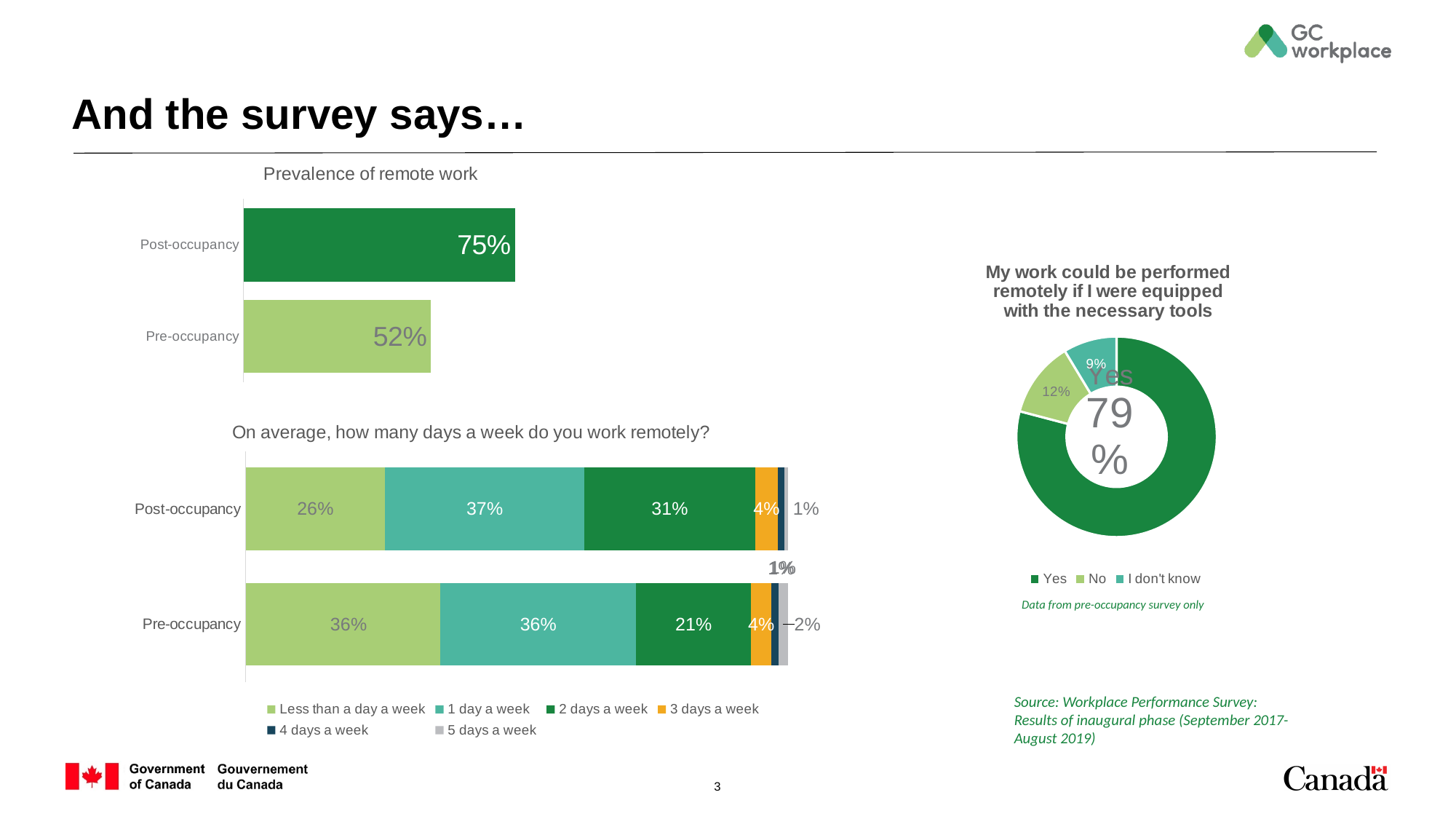
In the 'On average, how many days a week do you work remotely?' chart, which is larger: the Post-occupancy value for '2 days a week' or the Pre-occupancy value for '2 days a week'? Post-occupancy In the 'On average, how many days a week do you work remotely?' chart, what is the Pre-occupancy value for '2 days a week'? 21% In the donut chart 'My work could be performed remotely if I were equipped with the necessary tools', what share answered 'Yes'? 79% In the 'On average, how many days a week do you work remotely?' chart, what is the Pre-occupancy value for 'Less than a day a week'? 36% In the donut chart 'My work could be performed remotely if I were equipped with the necessary tools', what share answered 'I don't know'? 9% In the 'On average, how many days a week do you work remotely?' chart, what is the Post-occupancy value for '1 day a week'? 37% In the 'Prevalence of remote work' chart, what is the difference between the Post-occupancy and Pre-occupancy values? 23% In the 'Prevalence of remote work' chart, what is the value for Pre-occupancy? 52% What kind of chart is 'Prevalence of remote work'? Bar chart In the 'On average, how many days a week do you work remotely?' chart, how many series does the legend list? 6 In the 'Prevalence of remote work' chart, which category has the higher value? Post-occupancy In the 'Prevalence of remote work' chart, what is the value for Post-occupancy? 75%